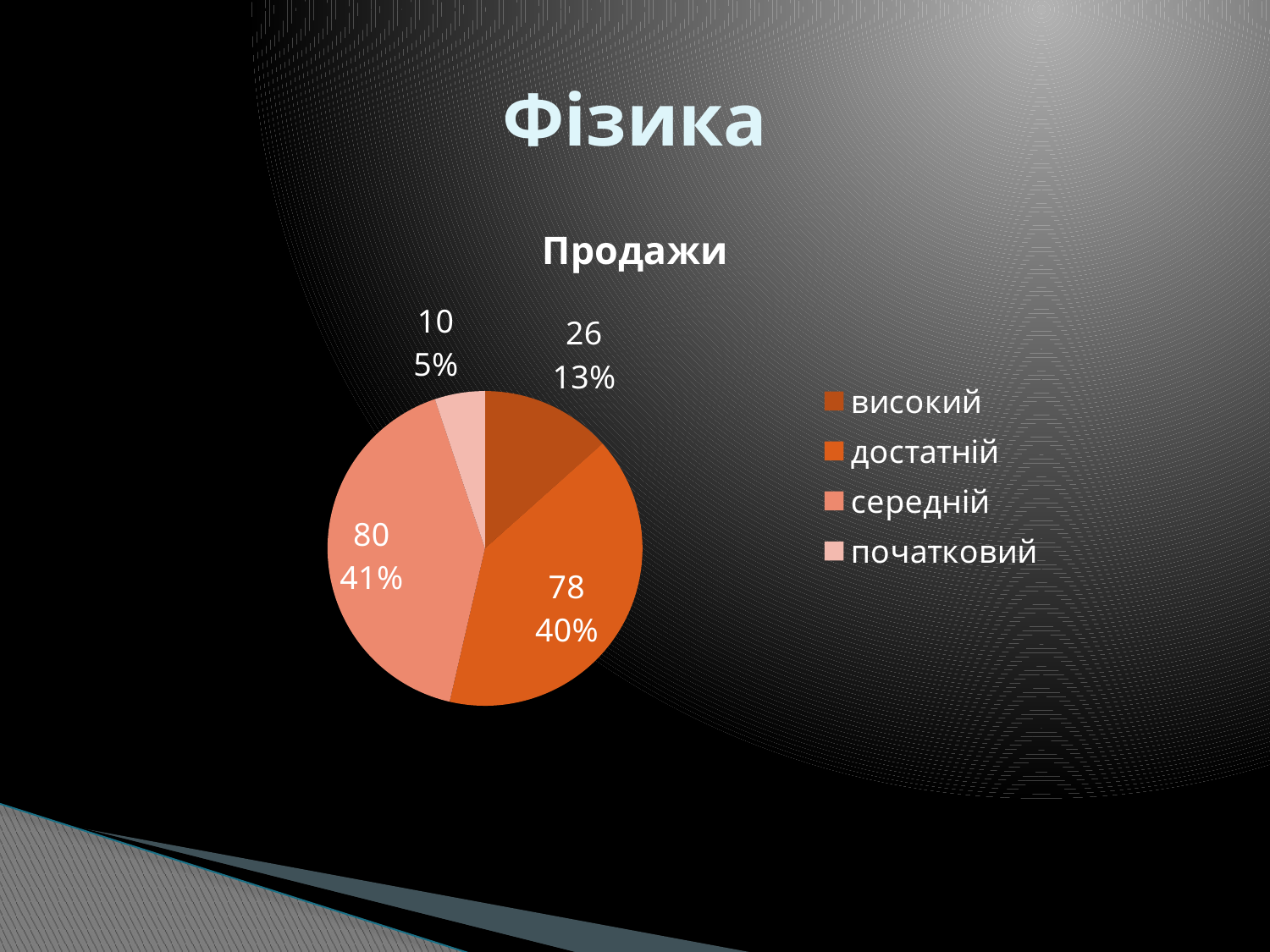
How many slices does the pie chart have? 4 What is the value for початковий? 10 What kind of chart is shown on the slide? pie chart Which category has the smallest value? початковий Which category has the largest value? середній What is the value for достатній? 78 What is the title of the chart? Продажи What is the value for високий? 26 What is the difference between the values for достатній and високий? 52 How many entries does the legend list? 4 What share of the pie does високий take? 13% What share of the pie does середній take? 41%